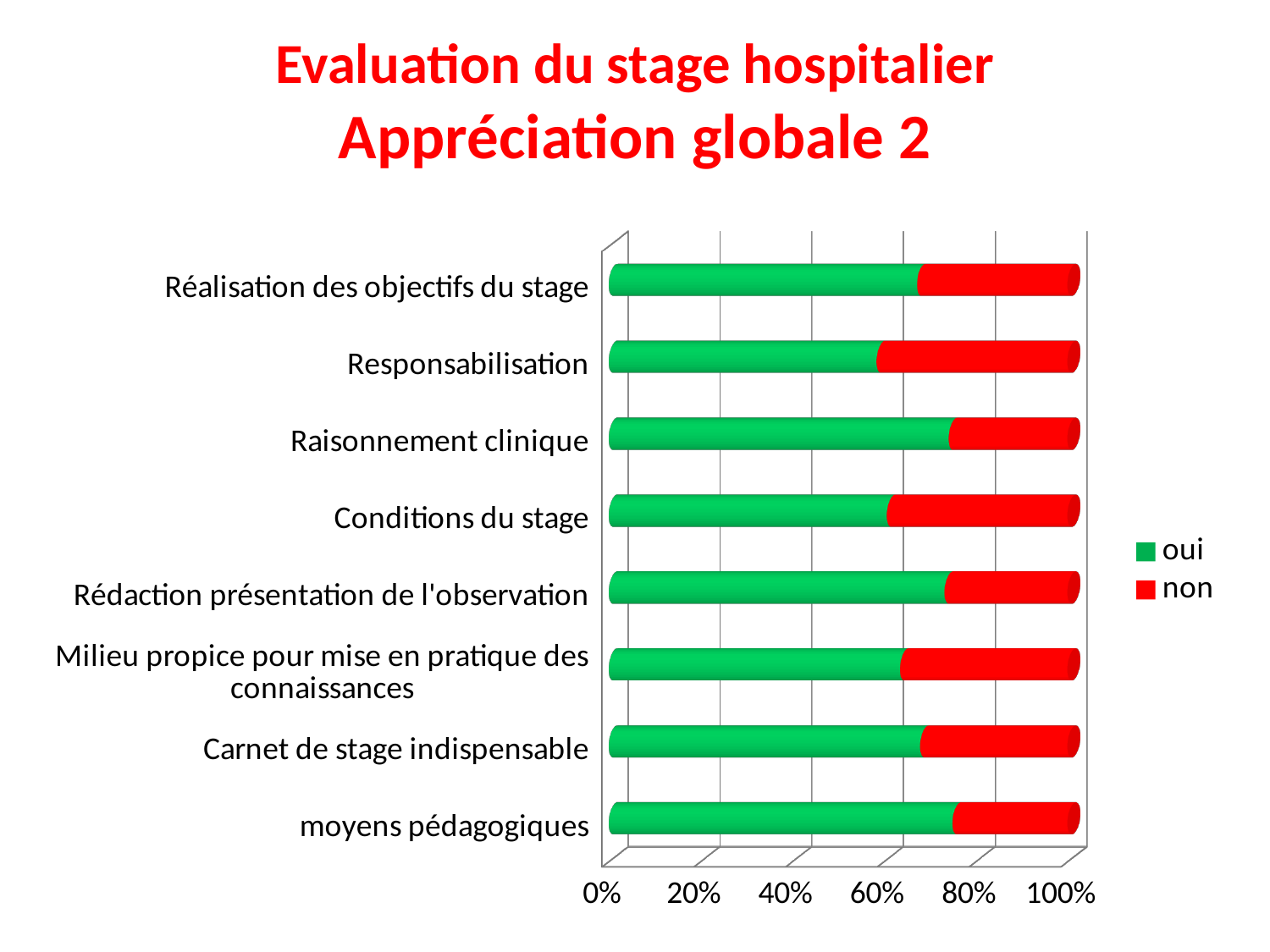
What kind of chart is shown on the slide? Stacked bar chart Which has the larger 'non' share: Responsabilisation or moyens pédagogiques? Responsabilisation How many series does the legend list? 2 Which colour represents the 'oui' series? Green Is the 'oui' value for Responsabilisation greater or less than 60%? less What are the two series named in the legend? oui and non Is the 'oui' value for Raisonnement clinique greater or less than 60%? greater Which has the larger 'oui' share: Raisonnement clinique or Responsabilisation? Raisonnement clinique Is the 'oui' value for Réalisation des objectifs du stage greater or less than 60%? greater How many categories are plotted on the chart? 8